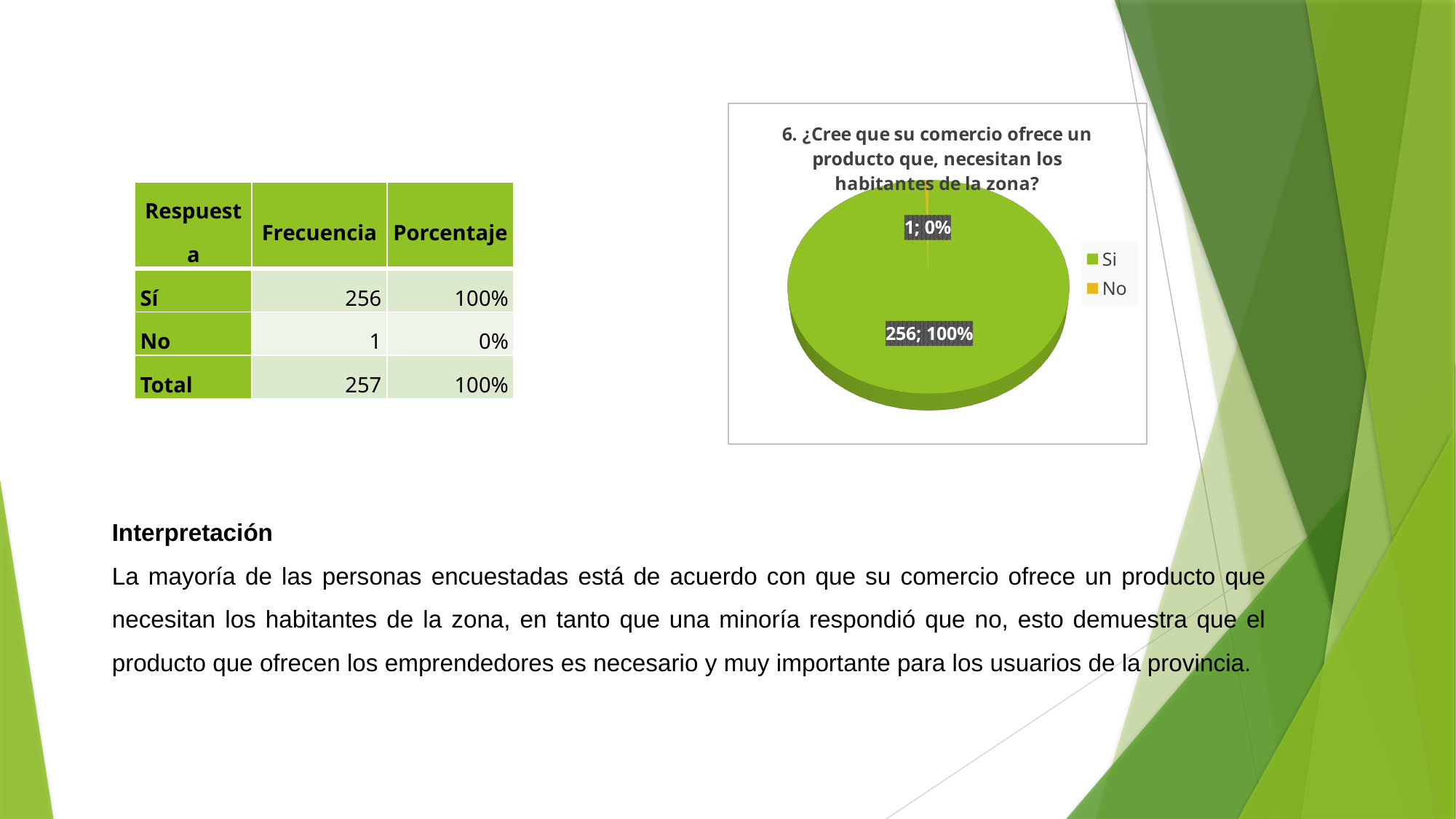
What is the title of the pie chart? 6. ¿Cree que su comercio ofrece un producto que, necesitan los habitantes de la zona? What is the difference between the 'Si' and 'No' values in the pie chart? 255 Which is larger in the pie chart, the 'Si' value or the 'No' value? Si Which slice of the pie chart is the smallest? No How many entries does the legend of the pie chart list? 2 What colour is the 'Si' slice in the pie chart? Green What is the value shown for the 'Si' slice of the pie chart? 256 Which slice of the pie chart is the largest? Si What percentage share does the 'Si' slice have in the pie chart? 100% What percentage share does the 'No' slice have in the pie chart? 0% What is the value shown for the 'No' slice of the pie chart? 1 What kind of chart is shown on the slide? Pie chart